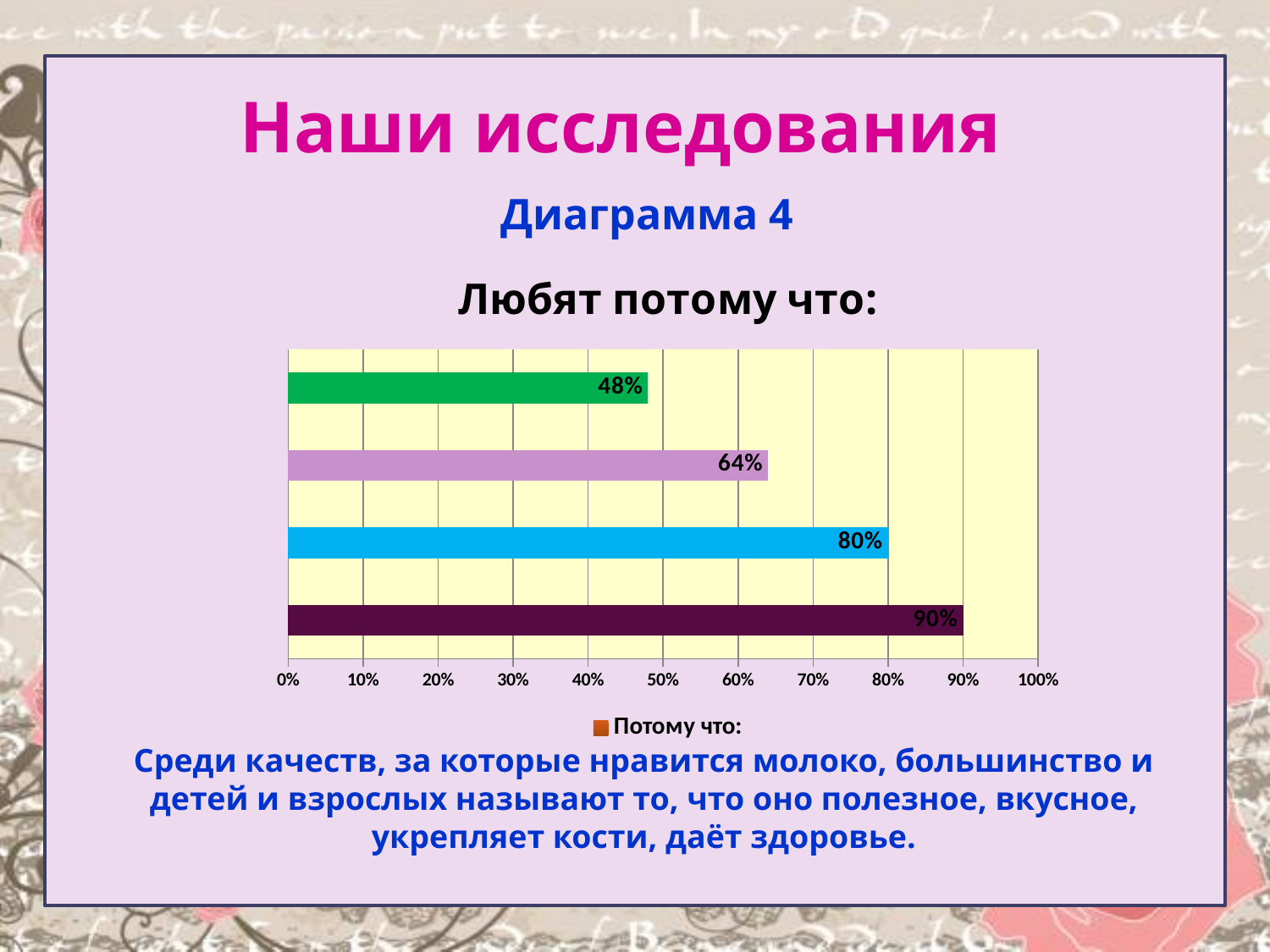
What type of chart is shown on the slide? bar chart What is the value shown on the dark purple bar at the bottom of the chart? 90% Which bar is longer, the lilac bar or the light blue bar? the light blue bar What is the value shown on the green bar at the top of the chart? 48% What is the lowest value shown in the chart? 48% How many series does the legend list? 1 How many bars are plotted in the chart? 4 What is the value shown on the light blue bar? 80% What is the difference between the bottom bar (90%) and the top bar (48%)? 42% What is the highest value shown in the chart? 90% What is the legend entry shown below the chart? Потому что: What is the title of the chart? Любят потому что: